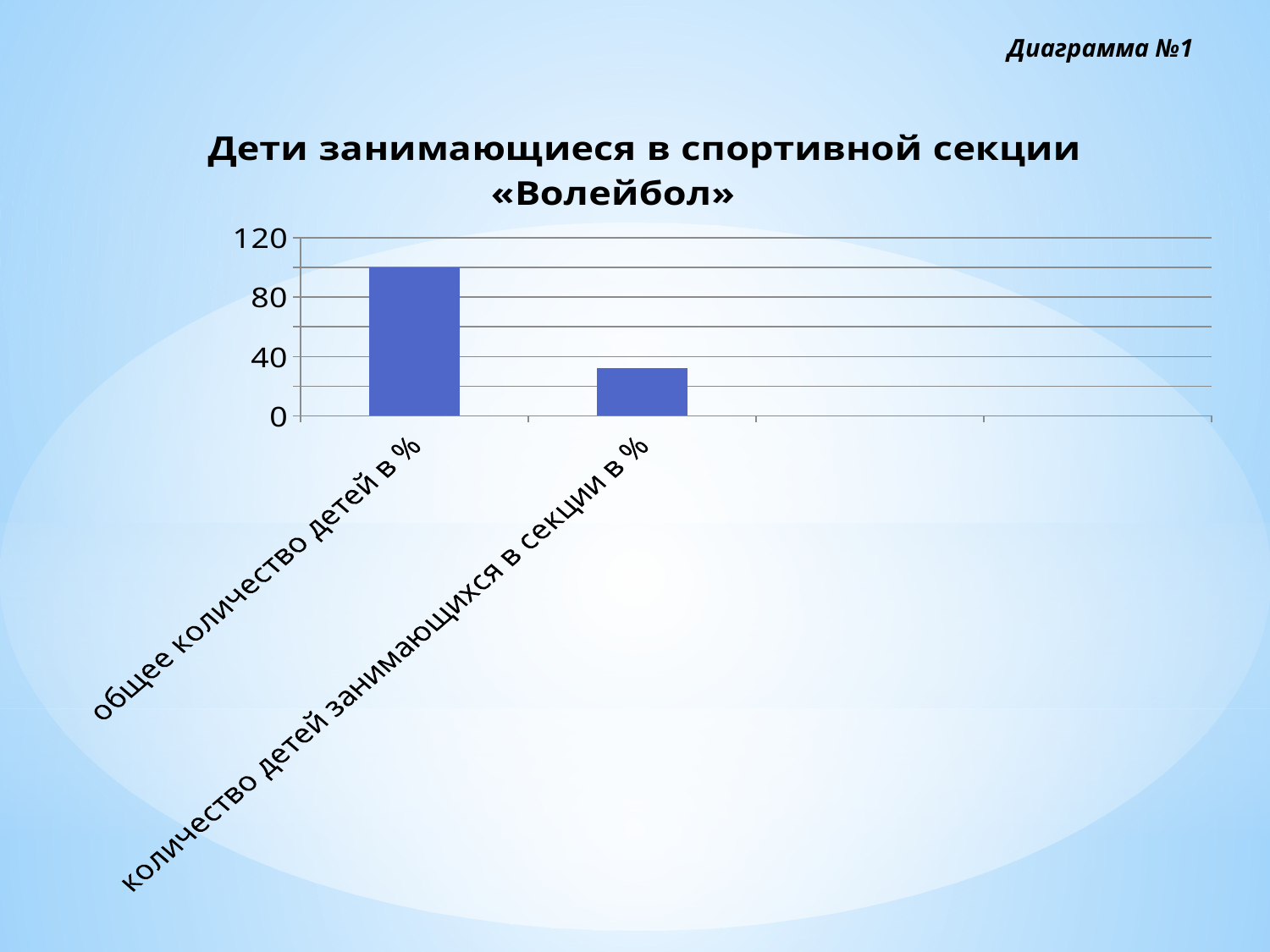
How many categories are plotted in the chart? 2 Which category has the highest value? общее количество детей в % Is the value for "количество детей занимающихся в секции в %" greater or less than 80? less Is the value for "общее количество детей в %" greater or less than 80? greater Which category has the lowest value? количество детей занимающихся в секции в % What is the title of the chart? Дети занимающиеся в спортивной секции «Волейбол» Which is larger: the value for "общее количество детей в %" or the value for "количество детей занимающихся в секции в %"? общее количество детей в % Do the bar values rise or fall from left to right along the x axis? fall Is the value for "количество детей занимающихся в секции в %" greater or less than 40? less What is the highest value labelled on the vertical axis? 120 What kind of chart is shown on the slide? bar chart